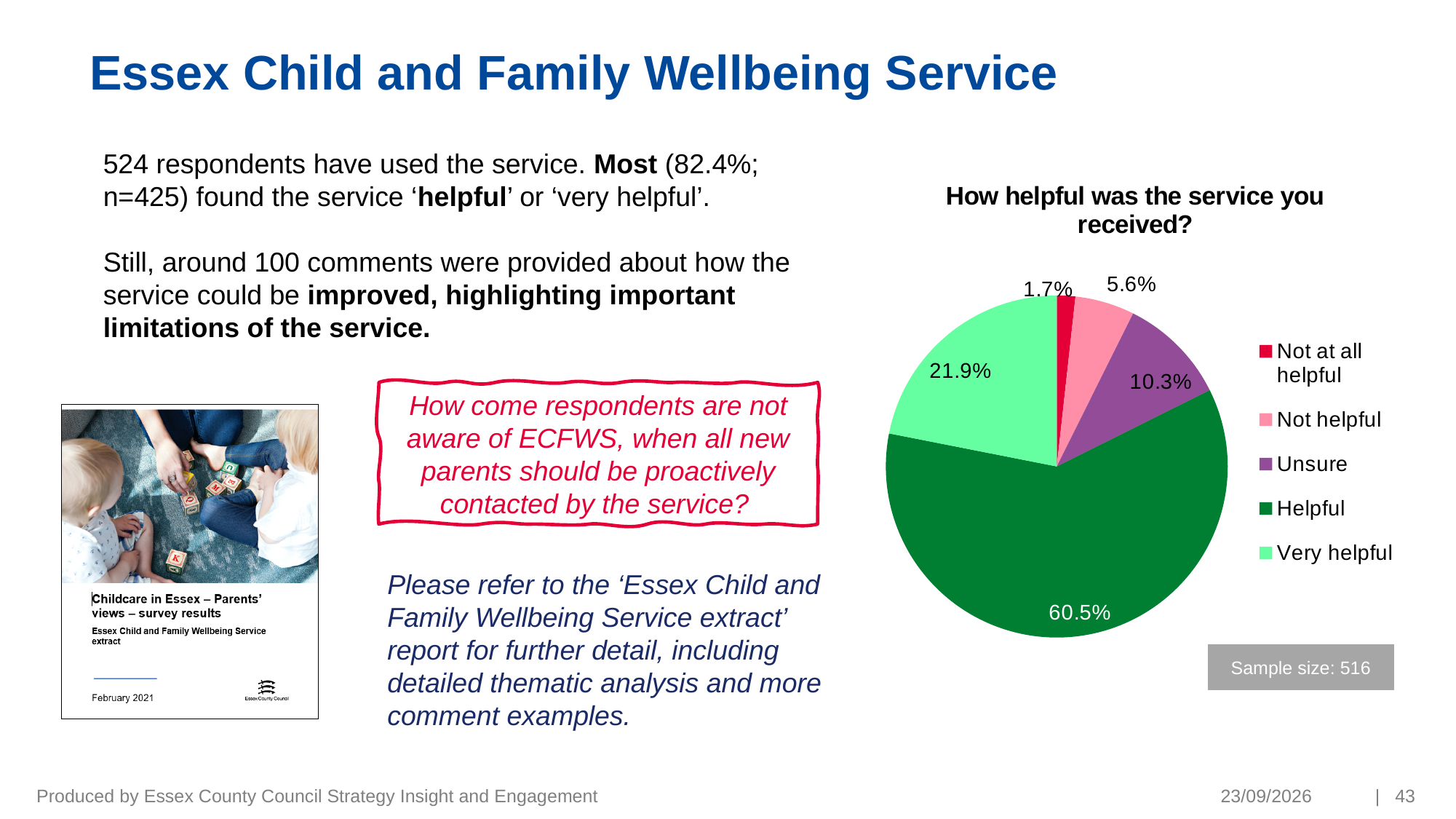
Which category has the smallest slice of the pie? Not at all helpful What share of respondents said the service was 'Not at all helpful'? 1.7% What kind of chart is shown on the slide? pie chart How many categories does the legend list? 5 What is the combined share of 'Helpful' and 'Very helpful'? 82.4% What share of respondents said the service was 'Very helpful'? 21.9% Which category has the largest slice of the pie? Helpful What share of respondents said the service was 'Helpful'? 60.5% Which is larger, the share for 'Not helpful' or the share for 'Unsure'? Unsure What share of respondents were 'Unsure'? 10.3% What is the title of the chart? How helpful was the service you received? What is the difference in percentage points between 'Helpful' and 'Very helpful'? 38.6